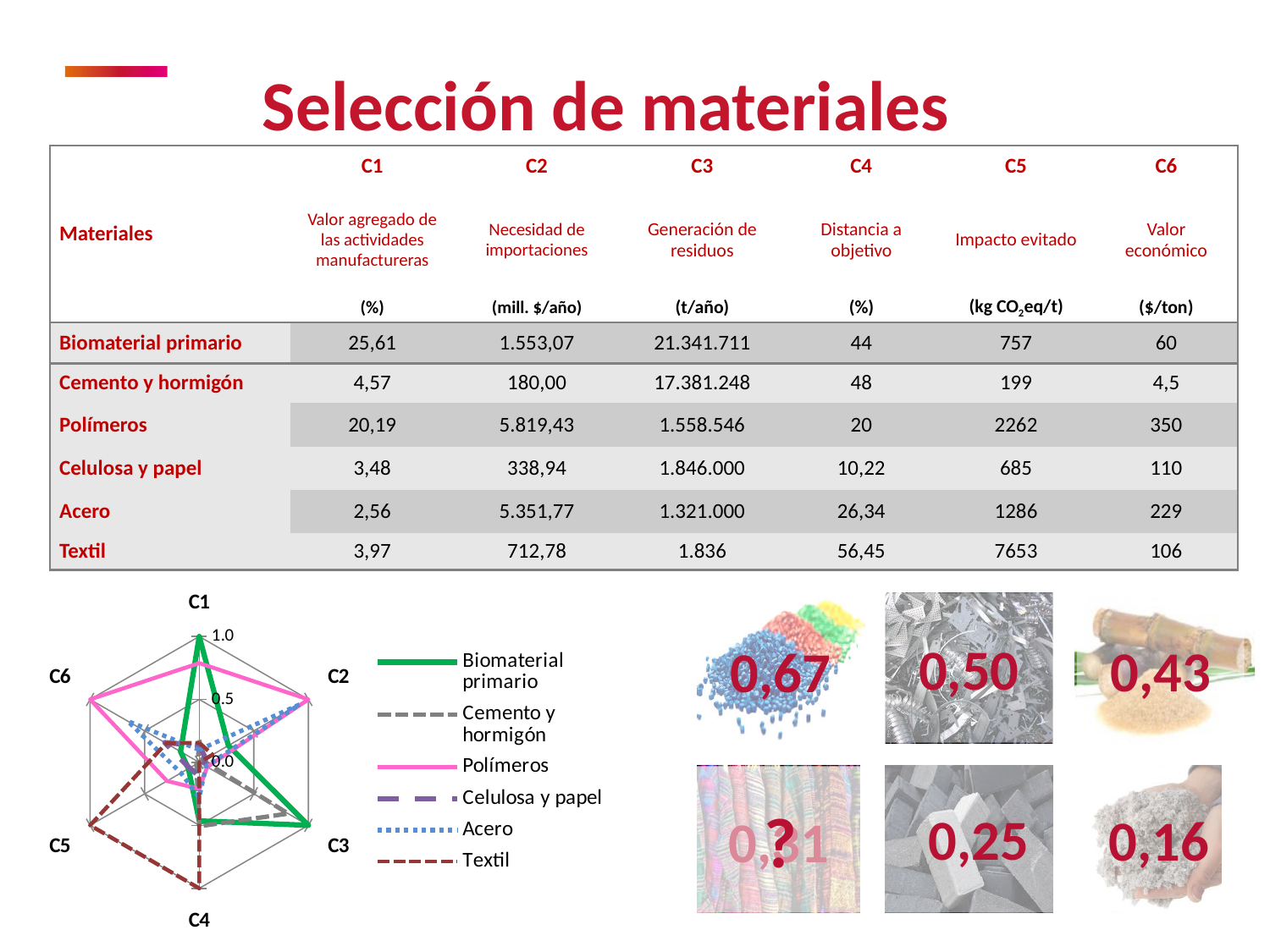
How many series does the legend of the radar chart list? 6 In the radar chart, which series reaches the highest value on the C6 axis? Polímeros In the radar chart, is the value for Textil on the C4 axis greater or less than 0.5? greater How many axes (criteria) does the radar chart have? 6 In the radar chart, which series reaches the highest value on the C1 axis? Biomaterial primario In the radar chart, is the value for Polímeros on the C6 axis greater or less than 0.5? greater What is the maximum tick value shown on the radar chart's scale? 1.0 Which series in the radar chart is drawn with a solid pink line? Polímeros In the radar chart, is the value for Biomaterial primario on the C1 axis greater or less than 0.5? greater In the radar chart, which series reaches the highest value on the C4 axis? Textil What kind of chart is shown at the bottom left of the slide? Radar chart